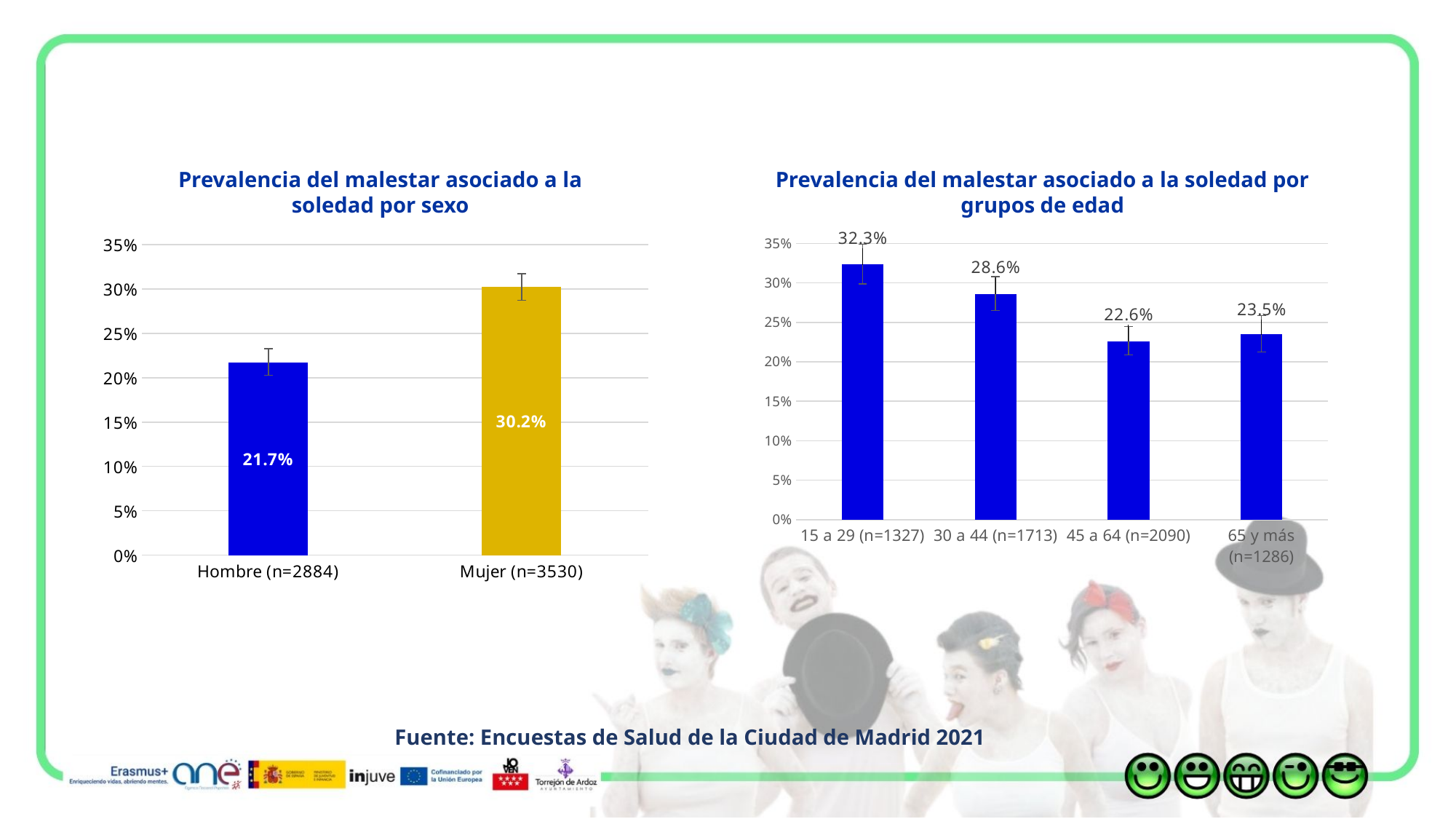
In the chart 'Prevalencia del malestar asociado a la soledad por sexo', what is the difference between the values for Mujer and Hombre? 8.5% In the chart 'Prevalencia del malestar asociado a la soledad por grupos de edad', what is the difference between the values for 15 a 29 and 30 a 44? 3.7% In the chart 'Prevalencia del malestar asociado a la soledad por grupos de edad', which age group has the highest value? 15 a 29 (n=1327) In the chart 'Prevalencia del malestar asociado a la soledad por sexo', what is the value for Hombre (n=2884)? 21.7% In the chart 'Prevalencia del malestar asociado a la soledad por grupos de edad', what is the value for 15 a 29 (n=1327)? 32.3% In the chart 'Prevalencia del malestar asociado a la soledad por sexo', which category has the higher value, Hombre or Mujer? Mujer In the chart 'Prevalencia del malestar asociado a la soledad por grupos de edad', how many age groups are shown? 4 In the chart 'Prevalencia del malestar asociado a la soledad por sexo', what is the value for Mujer (n=3530)? 30.2% What kind of chart is 'Prevalencia del malestar asociado a la soledad por grupos de edad'? Bar chart In the chart 'Prevalencia del malestar asociado a la soledad por grupos de edad', which age group has the lowest value? 45 a 64 (n=2090) In the chart 'Prevalencia del malestar asociado a la soledad por grupos de edad', what is the value for 45 a 64 (n=2090)? 22.6% In the chart 'Prevalencia del malestar asociado a la soledad por sexo', what colour is the bar for Mujer? Yellow